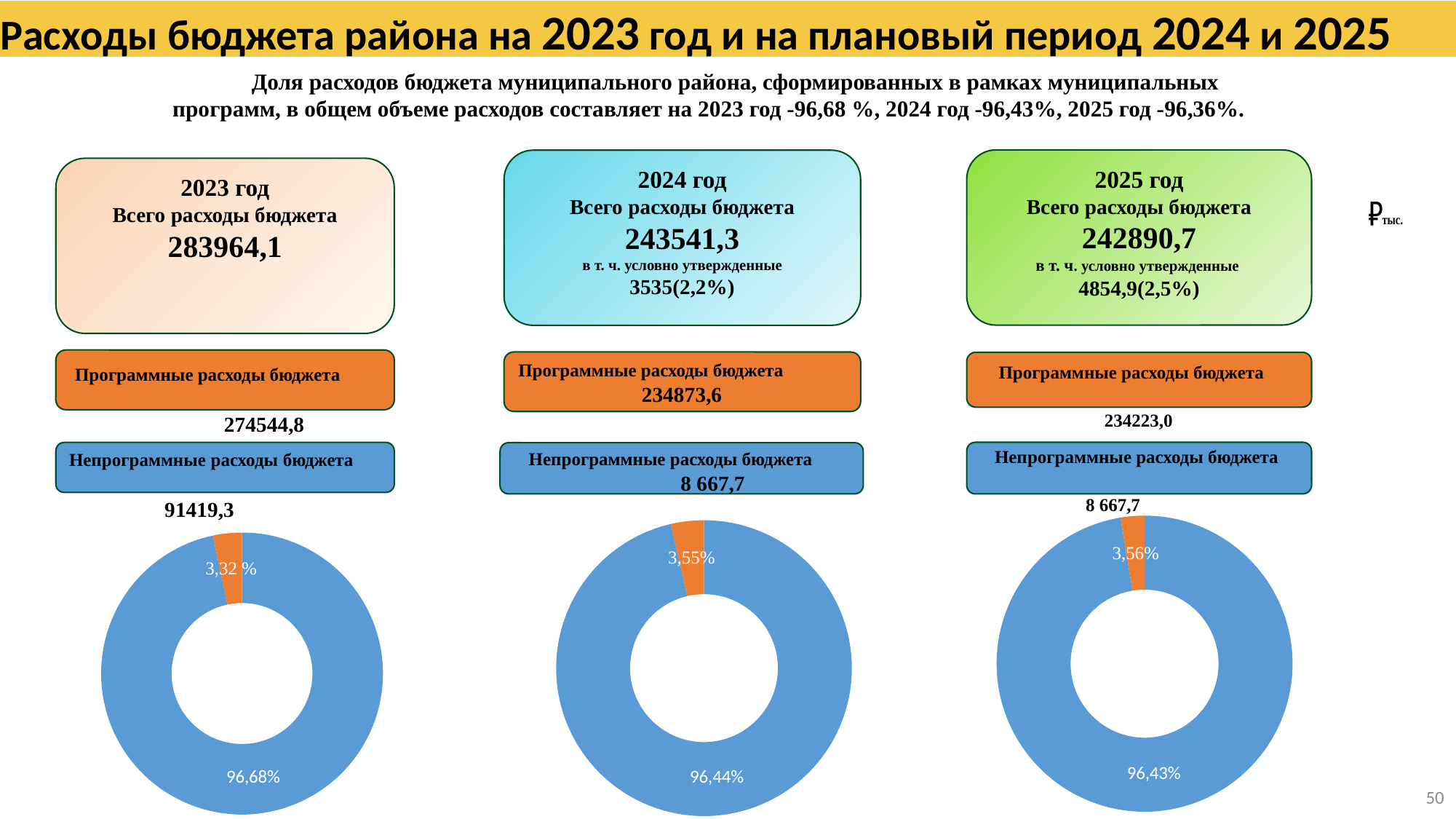
In the middle (2024) doughnut chart, what percentage is shown on the orange slice? 3,55% What kind of chart is shown under the 2023 column on the left of the slide? Doughnut chart In the right (2025) doughnut chart, what percentage is shown on the blue slice? 96,43% In the right (2025) doughnut chart, what percentage is shown on the orange slice? 3,56% In the left (2023) doughnut chart, what percentage is shown on the large blue slice? 96,68% Which of the three doughnut charts has the largest orange slice by its printed percentage? The right (2025) chart In the left (2023) doughnut chart, which slice is larger, the blue one or the orange one? The blue one In the left (2023) doughnut chart, what percentage is shown on the small orange slice? 3,32 % How many doughnut charts are shown on the slide? 3 How many slices does the left (2023) doughnut chart have? 2 What colour is the large slice in each of the three doughnut charts? Blue In the middle (2024) doughnut chart, what percentage is shown on the blue slice? 96,44%